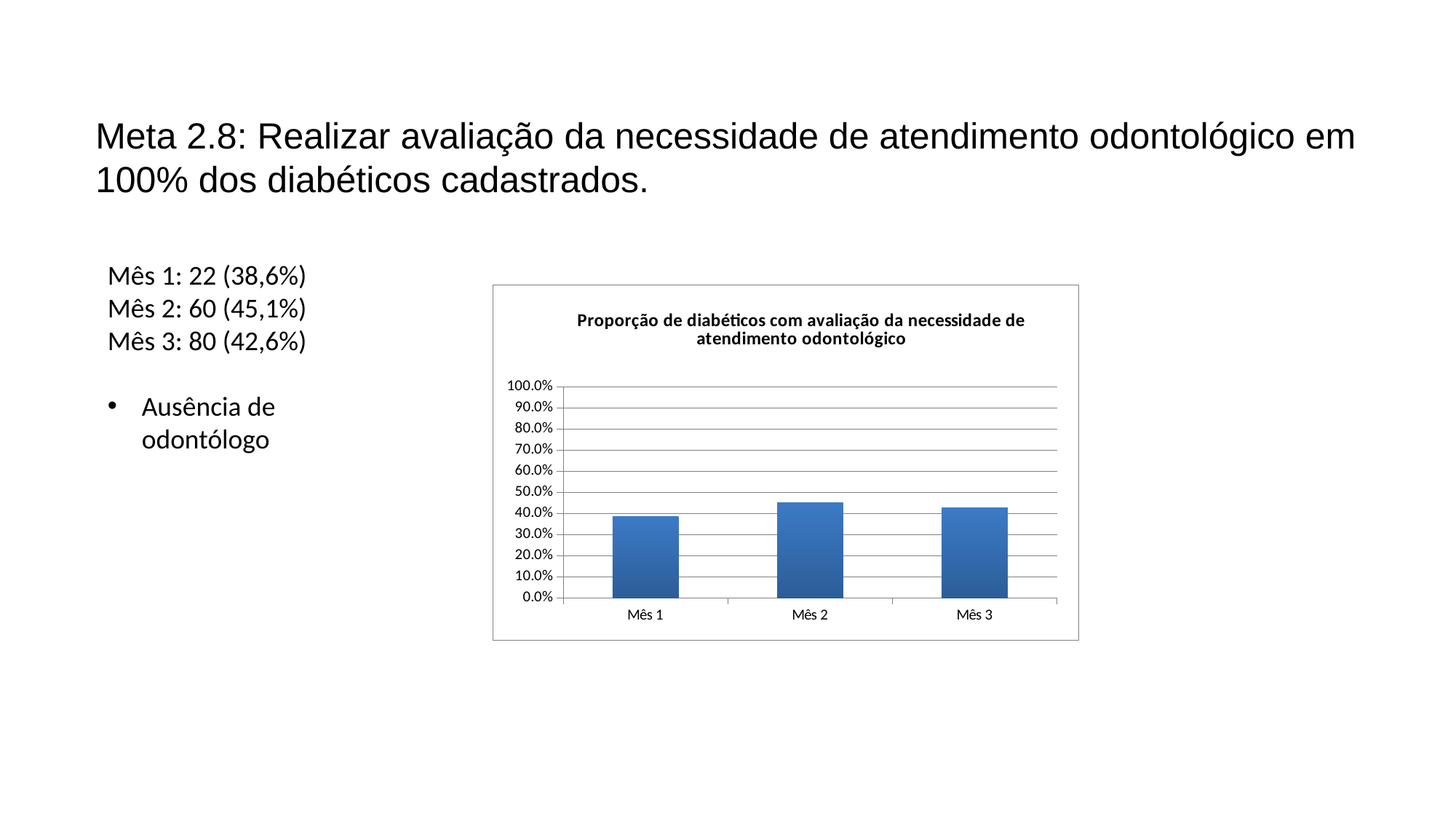
What kind of chart is shown on the slide? bar chart What is the highest value shown on the chart's vertical axis? 100.0% What is the title of the chart? Proporção de diabéticos com avaliação da necessidade de atendimento odontológico Is the bar for Mês 1 larger or smaller than the bar for Mês 3? smaller Is the value for Mês 3 greater or less than 50.0%? less According to the slide, what proportion is shown for Mês 1? 38,6% How many categories (months) are plotted in the chart? 3 Is the value for Mês 1 greater or less than 40.0%? less According to the slide, what proportion is shown for Mês 2? 45,1% Is the value for Mês 2 greater or less than 40.0%? greater Which month has the highest bar in the chart? Mês 2 Which month has the lowest bar in the chart? Mês 1